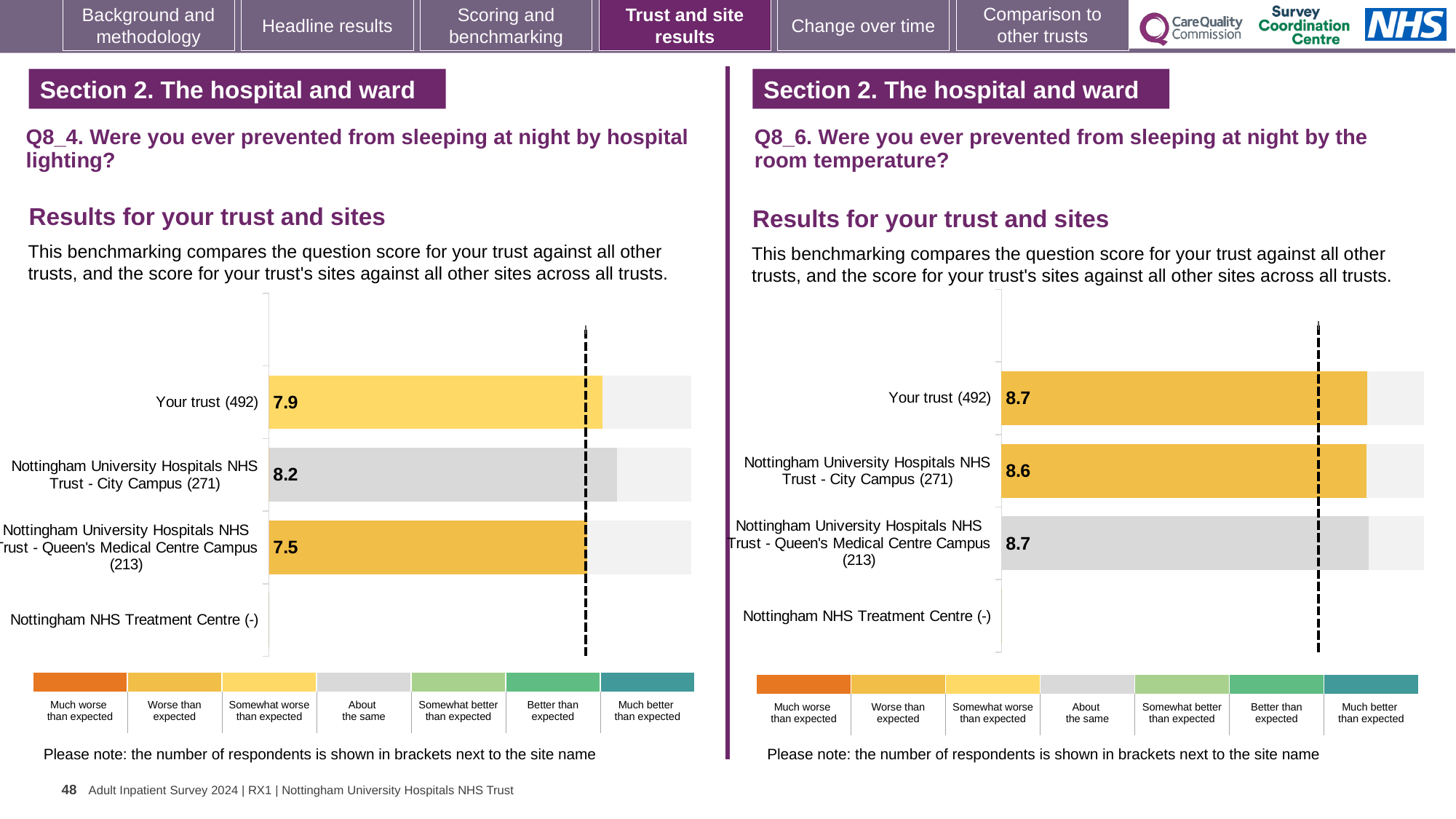
What type of chart is used for the Q8_4 hospital lighting results? Bar chart In the Q8_4 hospital lighting chart, what is the score for Nottingham University Hospitals NHS Trust - City Campus (271)? 8.2 In the Q8_4 hospital lighting chart, what is the difference between the City Campus score and the Queen's Medical Centre Campus score? 0.7 In the Q8_6 room temperature chart, which site or trust has the lowest score? Nottingham University Hospitals NHS Trust - City Campus (271) In the Q8_6 room temperature chart, what is the score for Nottingham University Hospitals NHS Trust - City Campus (271)? 8.6 In the Q8_4 hospital lighting chart, what is the score for Your trust (492)? 7.9 In the Q8_4 hospital lighting chart, which benchmark category does the grey colour of the City Campus bar represent according to the legend? About the same In the Q8_6 room temperature chart, what is the score for Nottingham University Hospitals NHS Trust - Queen's Medical Centre Campus (213)? 8.7 In the Q8_4 hospital lighting chart, which has the higher score: Your trust or the Queen's Medical Centre Campus? Your trust In the Q8_4 hospital lighting chart, which site or trust has the highest score? Nottingham University Hospitals NHS Trust - City Campus (271) In the Q8_4 hospital lighting chart, which site or trust has the lowest score? Nottingham University Hospitals NHS Trust - Queen's Medical Centre Campus (213) How many categories are listed on the y axis of the Q8_6 room temperature chart? 4